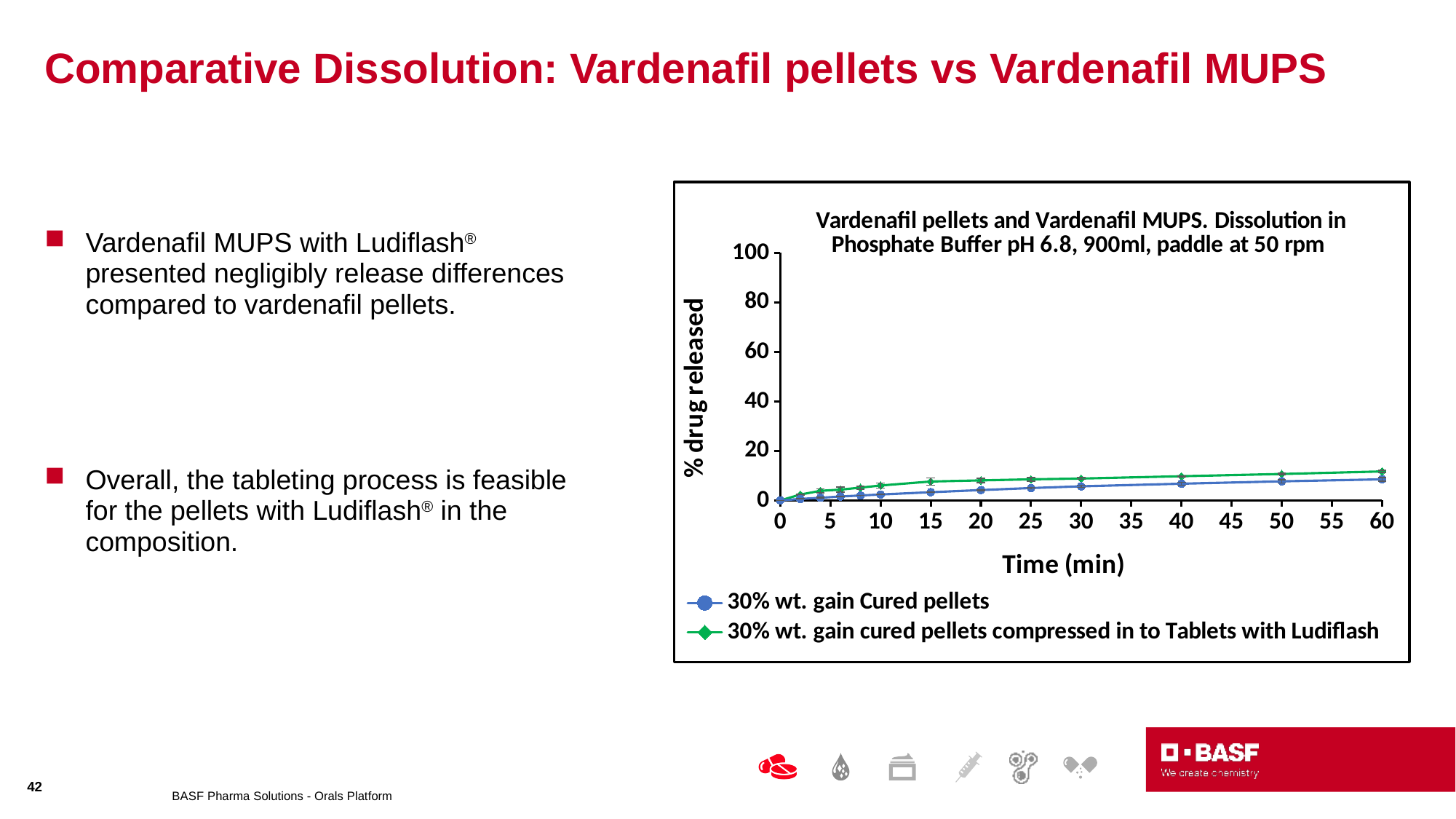
Do the values for the '30% wt. gain cured pellets compressed in to Tablets with Ludiflash' series rise or fall along the x axis? rise What is the highest value shown on the y axis of the chart? 100 Do the values for the '30% wt. gain Cured pellets' series rise or fall as time increases? rise Is the value for '30% wt. gain cured pellets compressed in to Tablets with Ludiflash' at 30 min greater or less than 40? less What kind of chart is shown on the slide? line chart At 10 min, which series has the higher value: '30% wt. gain Cured pellets' or '30% wt. gain cured pellets compressed in to Tablets with Ludiflash'? 30% wt. gain cured pellets compressed in to Tablets with Ludiflash Is the value for '30% wt. gain Cured pellets' at 60 min greater or less than 20? less What is the label of the y axis of the chart? % drug released Is the value for '30% wt. gain cured pellets compressed in to Tablets with Ludiflash' at 60 min greater or less than 20? less What is the title of the chart? Vardenafil pellets and Vardenafil MUPS. Dissolution in Phosphate Buffer pH 6.8, 900ml, paddle at 50 rpm How many series does the chart legend list? 2